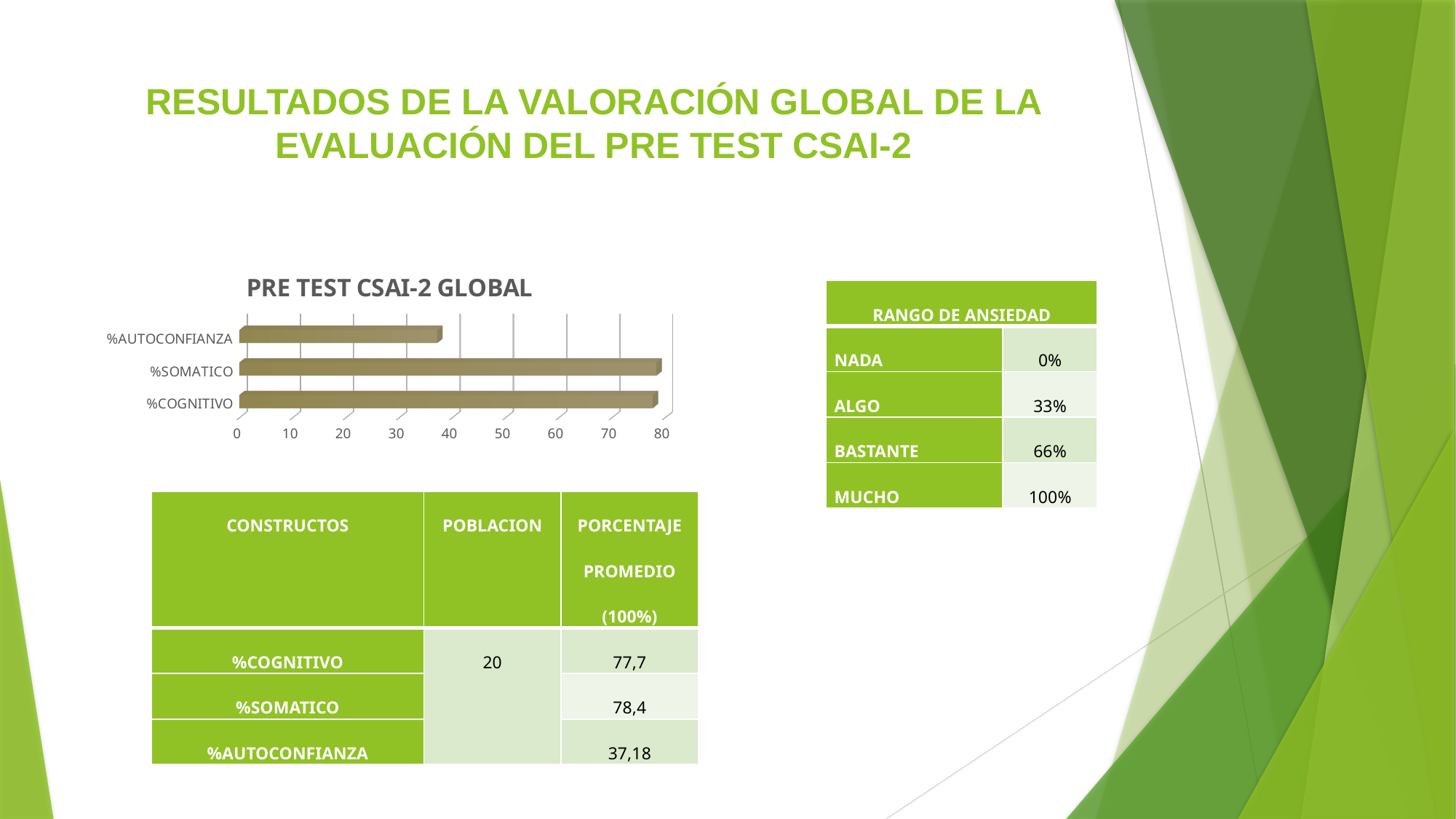
In the "PRE TEST CSAI-2 GLOBAL" chart, which is larger, %SOMATICO or %AUTOCONFIANZA? %SOMATICO How many categories are shown in the "PRE TEST CSAI-2 GLOBAL" chart? 3 In the "PRE TEST CSAI-2 GLOBAL" chart, is the value for %AUTOCONFIANZA greater or less than 30? greater What is the highest value shown on the horizontal axis of the "PRE TEST CSAI-2 GLOBAL" chart? 80 What kind of chart is the "PRE TEST CSAI-2 GLOBAL" chart? bar chart In the "PRE TEST CSAI-2 GLOBAL" chart, is the value for %COGNITIVO greater or less than 80? less In the "PRE TEST CSAI-2 GLOBAL" chart, is the value for %AUTOCONFIANZA greater or less than 40? less Which category has the lowest value in the "PRE TEST CSAI-2 GLOBAL" chart? %AUTOCONFIANZA In the "PRE TEST CSAI-2 GLOBAL" chart, which is larger, %AUTOCONFIANZA or %COGNITIVO? %COGNITIVO What is the title of the bar chart on the slide? PRE TEST CSAI-2 GLOBAL